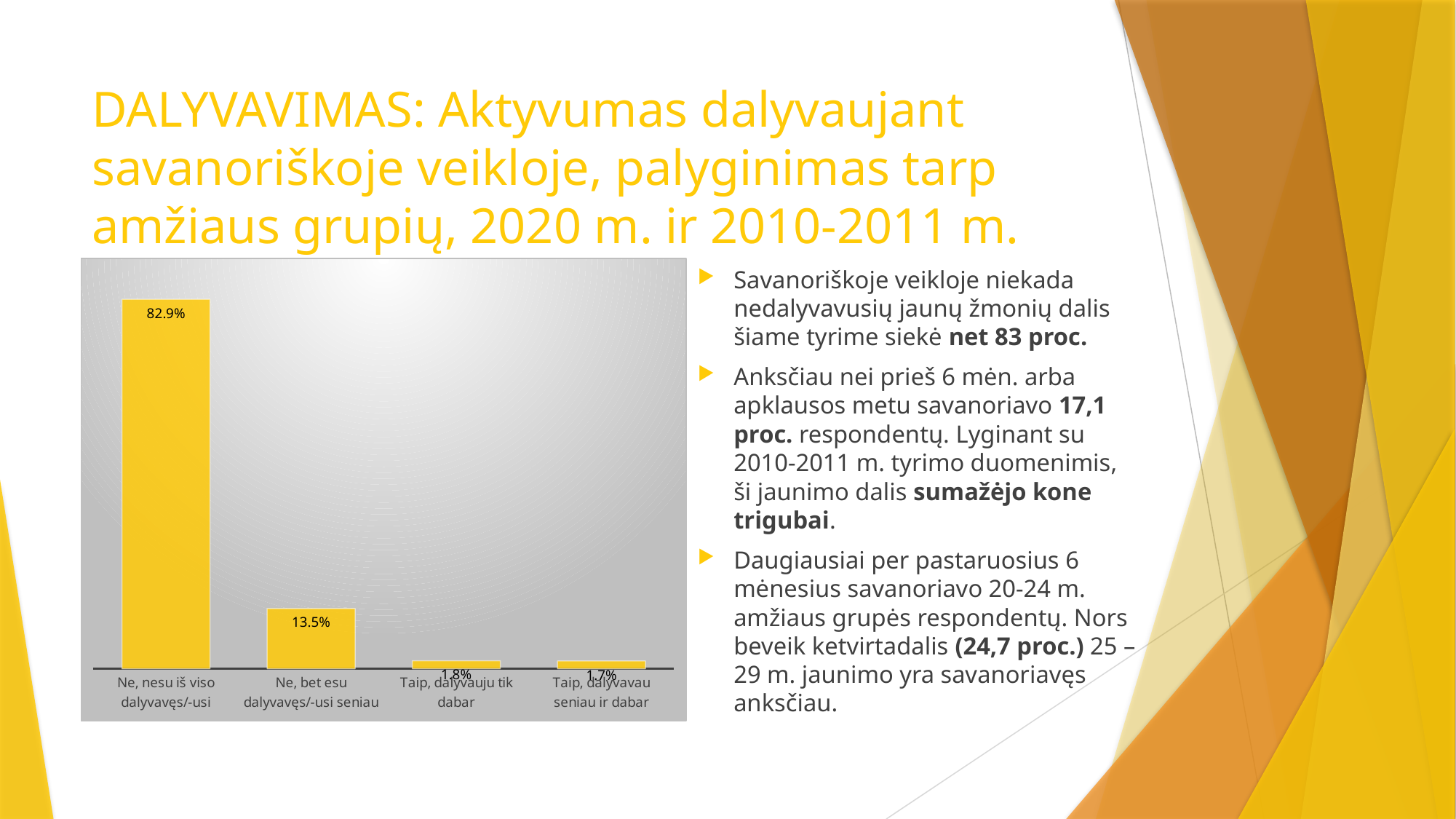
What is the difference between the values for "Ne, bet esu dalyvavęs/-usi seniau" and "Taip, dalyvauju tik dabar"? 11.7 percentage points How many categories are shown in the chart? 4 What is the value for "Ne, nesu iš viso dalyvavęs/-usi"? 82.9% Which category has the lowest value according to the data labels? Taip, dalyvavau seniau ir dabar What is the value for "Ne, bet esu dalyvavęs/-usi seniau"? 13.5% What kind of chart is shown on the slide? Bar chart Do the values rise or fall from left to right across the categories? Fall Which category has the highest value? Ne, nesu iš viso dalyvavęs/-usi What is the difference between the values for "Ne, nesu iš viso dalyvavęs/-usi" and "Ne, bet esu dalyvavęs/-usi seniau"? 69.4 percentage points Which is larger: the value for "Ne, bet esu dalyvavęs/-usi seniau" or for "Taip, dalyvauju tik dabar"? Ne, bet esu dalyvavęs/-usi seniau What is the value for "Taip, dalyvauju tik dabar"? 1.8% What is the value for "Taip, dalyvavau seniau ir dabar"? 1.7%